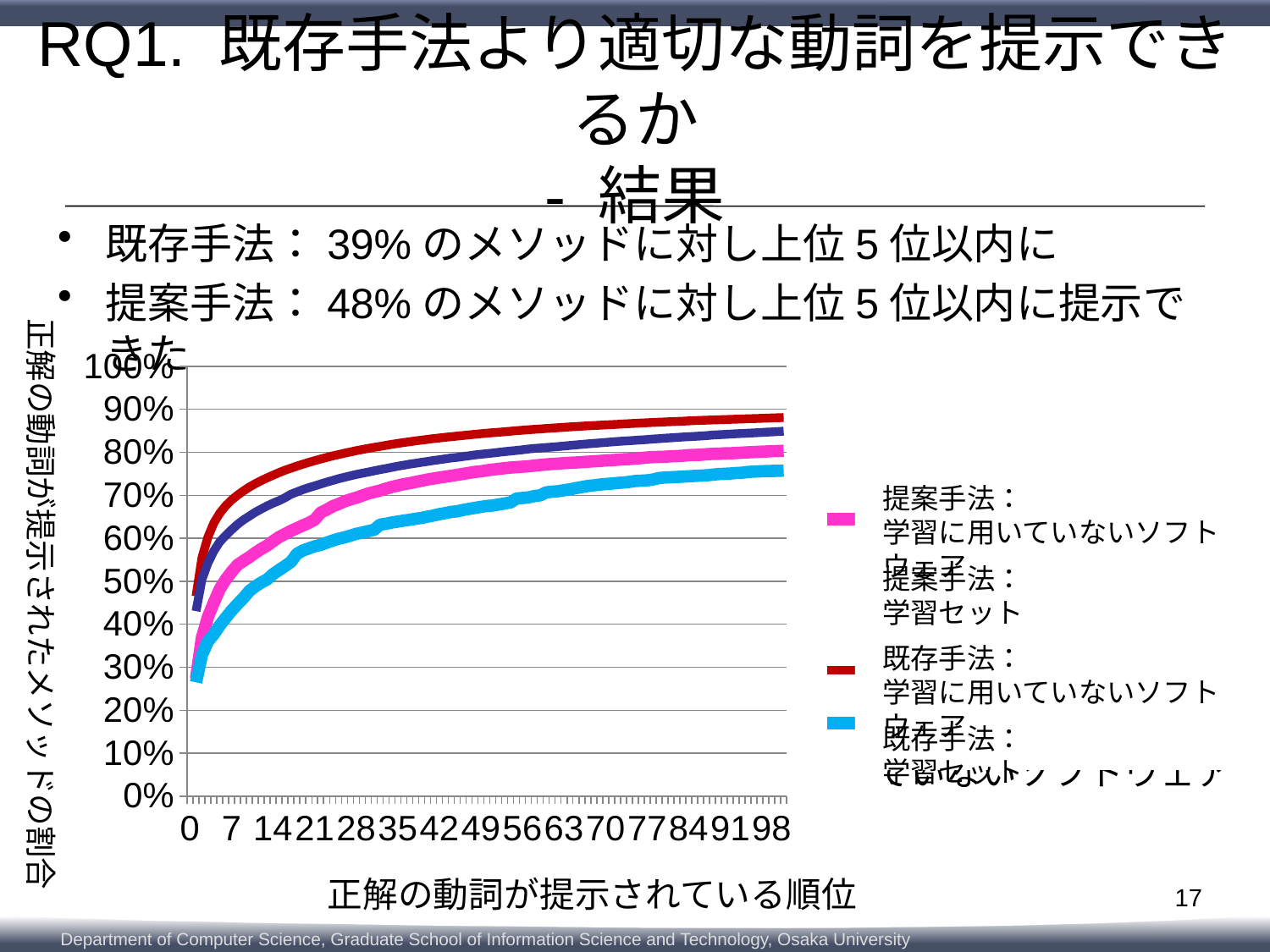
Which colored line is the highest at the right end of the chart (rank 98)? dark red Is the value of the dark red line at rank 98 greater or less than 80%? greater Is the value of the dark red line at rank 0 greater or less than 40%? greater What is the highest tick label on the chart's y axis? 100% What is the title of the chart's x axis? 正解の動詞が提示されている順位 What kind of chart is shown on the slide? line chart Do the lines in the chart rise or fall as the rank on the x axis increases? rise Is the value of the pink line at rank 0 greater or less than 40%? less How many series does the chart's legend list? 4 Which colored line is the lowest across the chart? light blue